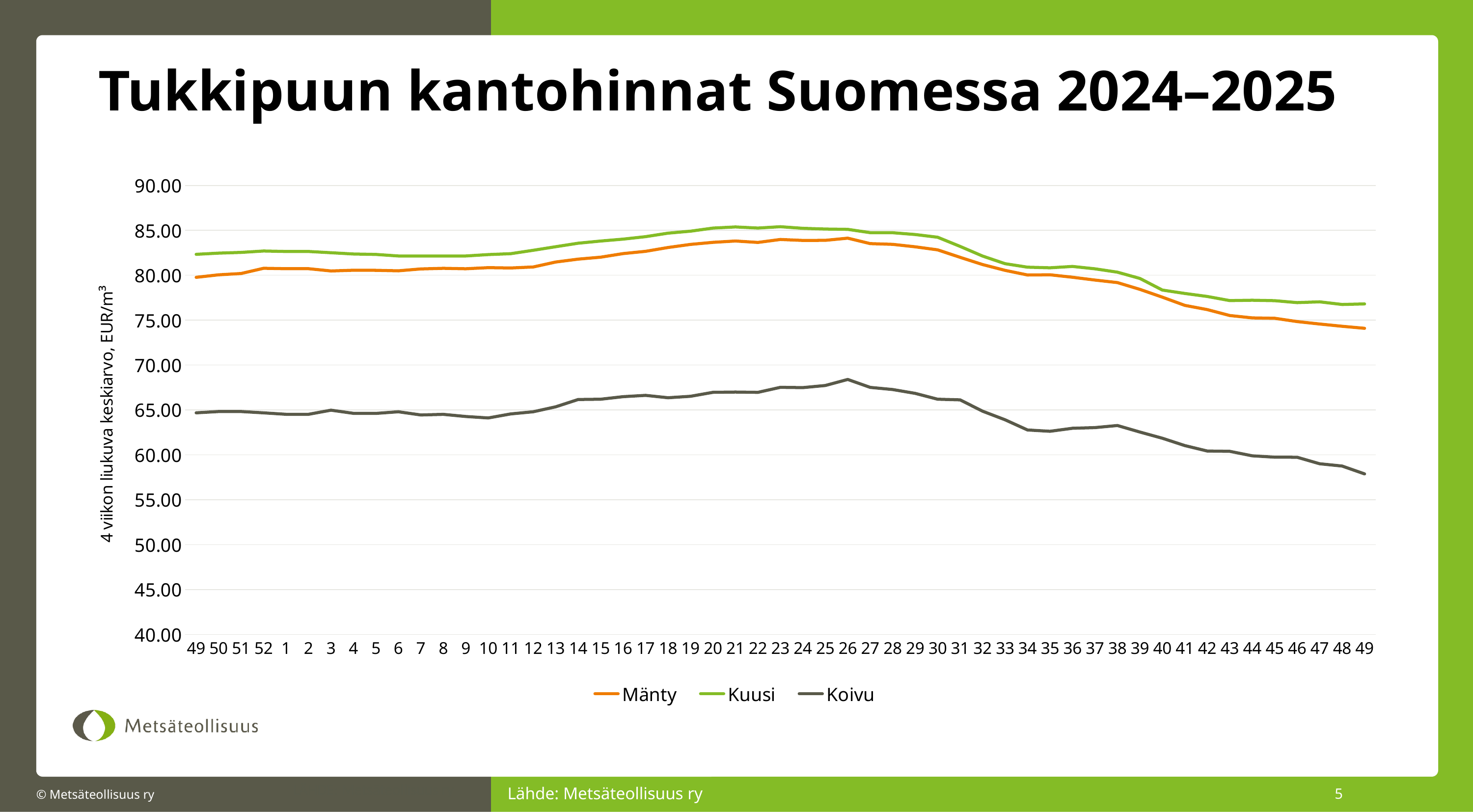
What kind of chart is shown on the slide? line chart Does the Koivu line rise or fall from week 26 to the final week 49? fall What is the title of the chart? Tukkipuun kantohinnat Suomessa 2024–2025 At week 26, which is larger, the value for Kuusi or the value for Mänty? Kuusi What is the label of the vertical axis? 4 viikon liukuva keskiarvo, EUR/m³ Which series has the highest values throughout the chart? Kuusi Is the value for Koivu at the final week 49 greater or less than 60.00? less How many series does the legend list? 3 Is the value for Koivu at week 26 greater or less than 65.00? greater Is the value for Mänty at week 26 greater or less than 80.00? greater Which series has the lowest values throughout the chart? Koivu